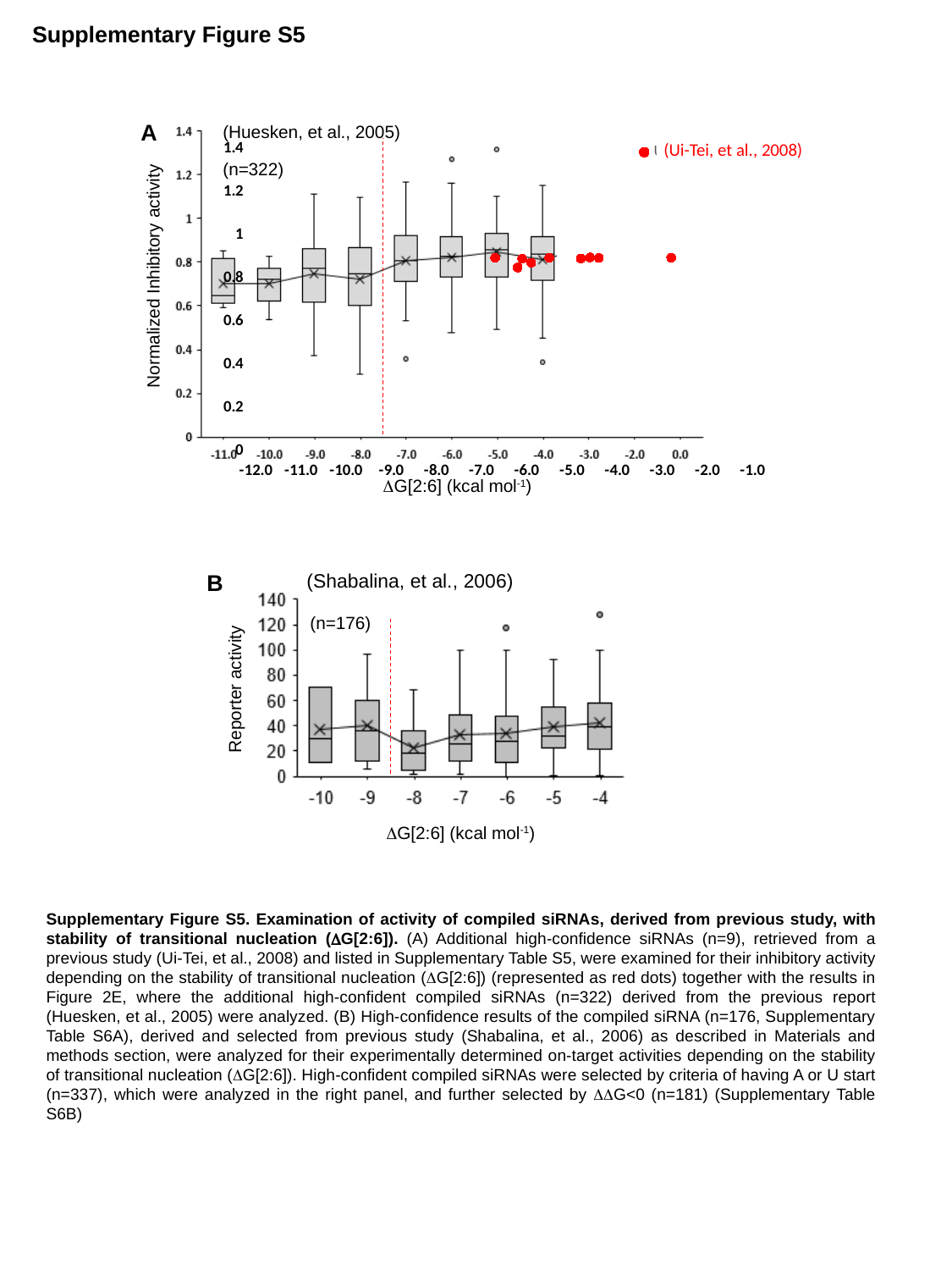
In panel B, what is the label of the y axis? Reporter activity In panel B, is the mean marker (x) for the box at ΔG[2:6] = -8 greater or less than 40? less In panel B, is the highest outlier point (above the box at -4) greater or less than 120? greater In panel A, is the highest outlier point greater or less than 1.2? greater In panel A, what is the label of the y axis? Normalized Inhibitory activity In panel B, does the line connecting the mean markers rise or fall from ΔG[2:6] = -8 to -4? rise In panel A, does the line connecting the mean markers of the boxes generally rise or fall from left to right? rise What kind of chart is panel B? box plot In panel B, what sample size (n) is printed on the chart? n=176 In panel B, which box has the lowest mean marker (x)? -8 In panel B, how many boxes (ΔG[2:6] categories) are plotted along the x axis? 7